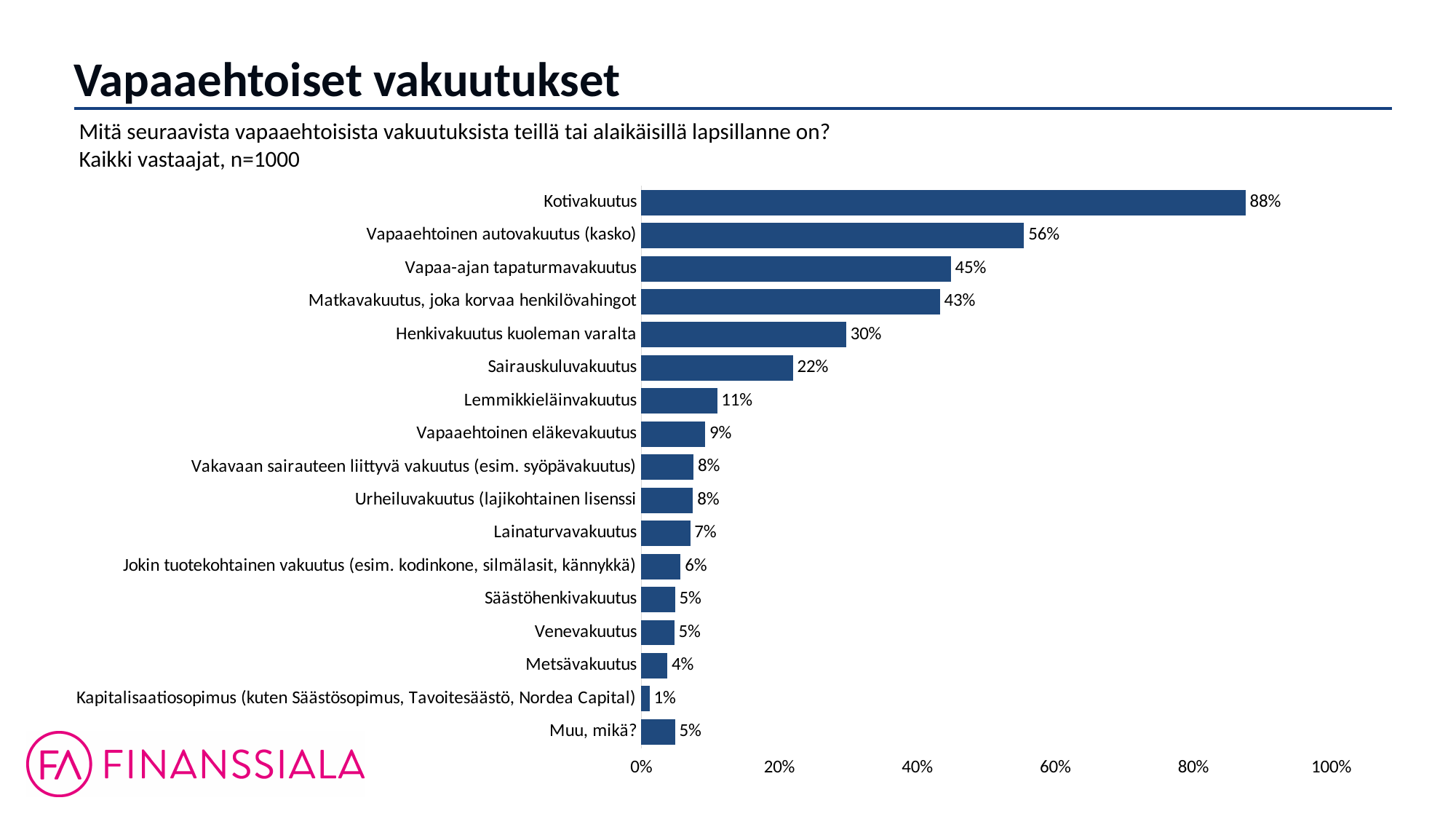
Which category has the highest value? Kotivakuutus What is the value for Henkivakuutus kuoleman varalta? 30% Which category has the lowest value? Kapitalisaatiosopimus (kuten Säästösopimus, Tavoitesäästö, Nordea Capital) What is the difference between the values for Kotivakuutus and Vapaaehtoinen autovakuutus (kasko)? 32% What is the value for Lemmikkieläinvakuutus? 11% What kind of chart is shown on the slide? bar chart What is the title of the slide? Vapaaehtoiset vakuutukset Which is larger, the value for Sairauskuluvakuutus or the value for Henkivakuutus kuoleman varalta? Henkivakuutus kuoleman varalta Is the value for Matkavakuutus, joka korvaa henkilövahingot greater or less than 40%? greater What is the difference between the values for Vapaa-ajan tapaturmavakuutus and Matkavakuutus, joka korvaa henkilövahingot? 2% What is the value for Kotivakuutus? 88% How many categories are shown in the chart? 17